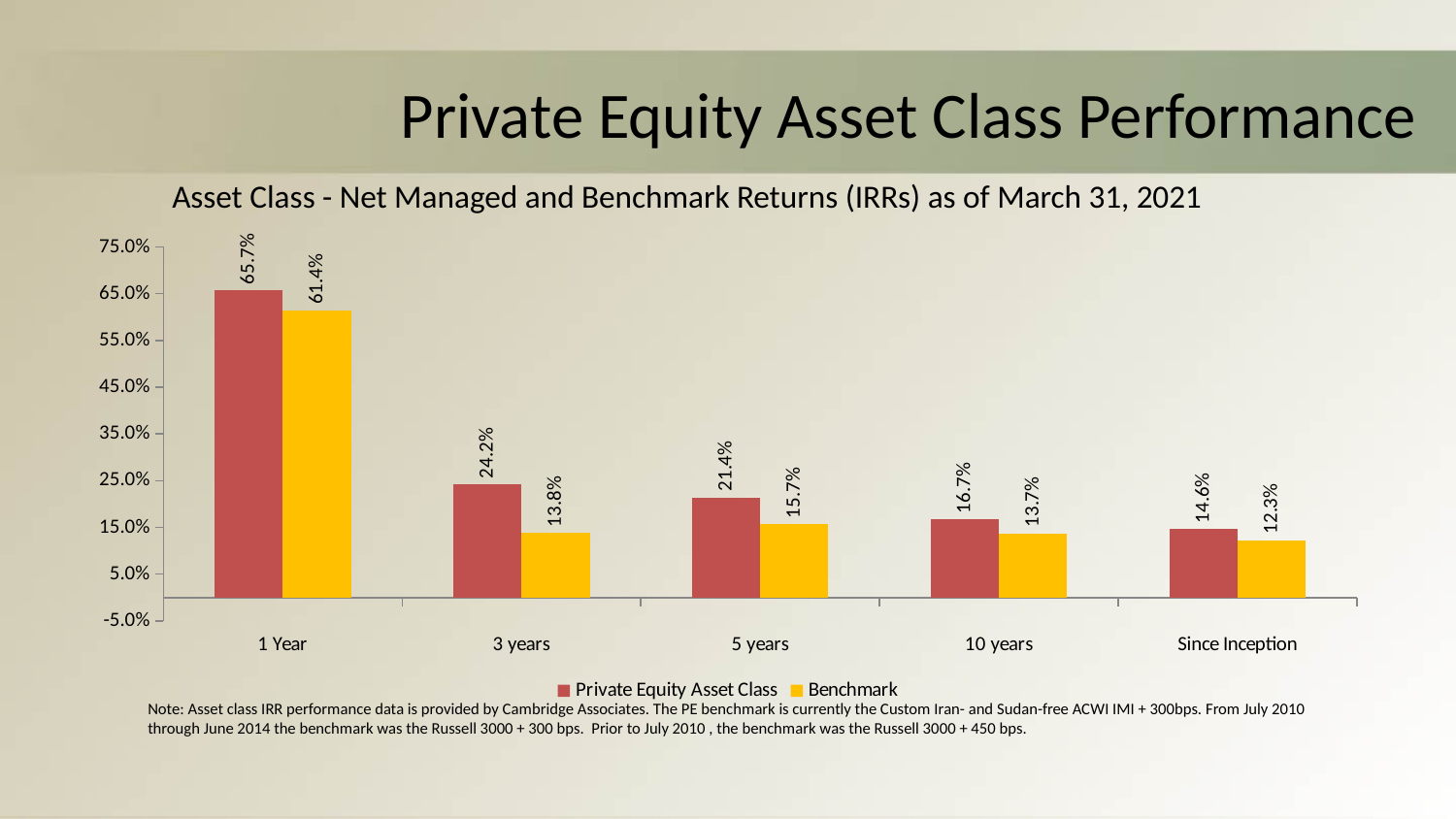
Which period has the highest Private Equity Asset Class return? 1 Year Which period has the lowest Benchmark return? Since Inception What is the difference between the Private Equity Asset Class return and the Benchmark return for the 3 years period? 10.4% How many time periods are shown on the x axis? 5 Is the Benchmark value for 1 Year greater or less than 55.0%? greater Which is larger for the 5 years period, the Private Equity Asset Class return or the Benchmark return? Private Equity Asset Class How many series does the legend list? 2 What is the Private Equity Asset Class return for the 1 Year period? 65.7% What is the Benchmark return for the 10 years period? 13.7% What colour represents the Benchmark series in the chart? Yellow What kind of chart is shown on the slide? Bar chart What is the Benchmark return for the 5 years period? 15.7%